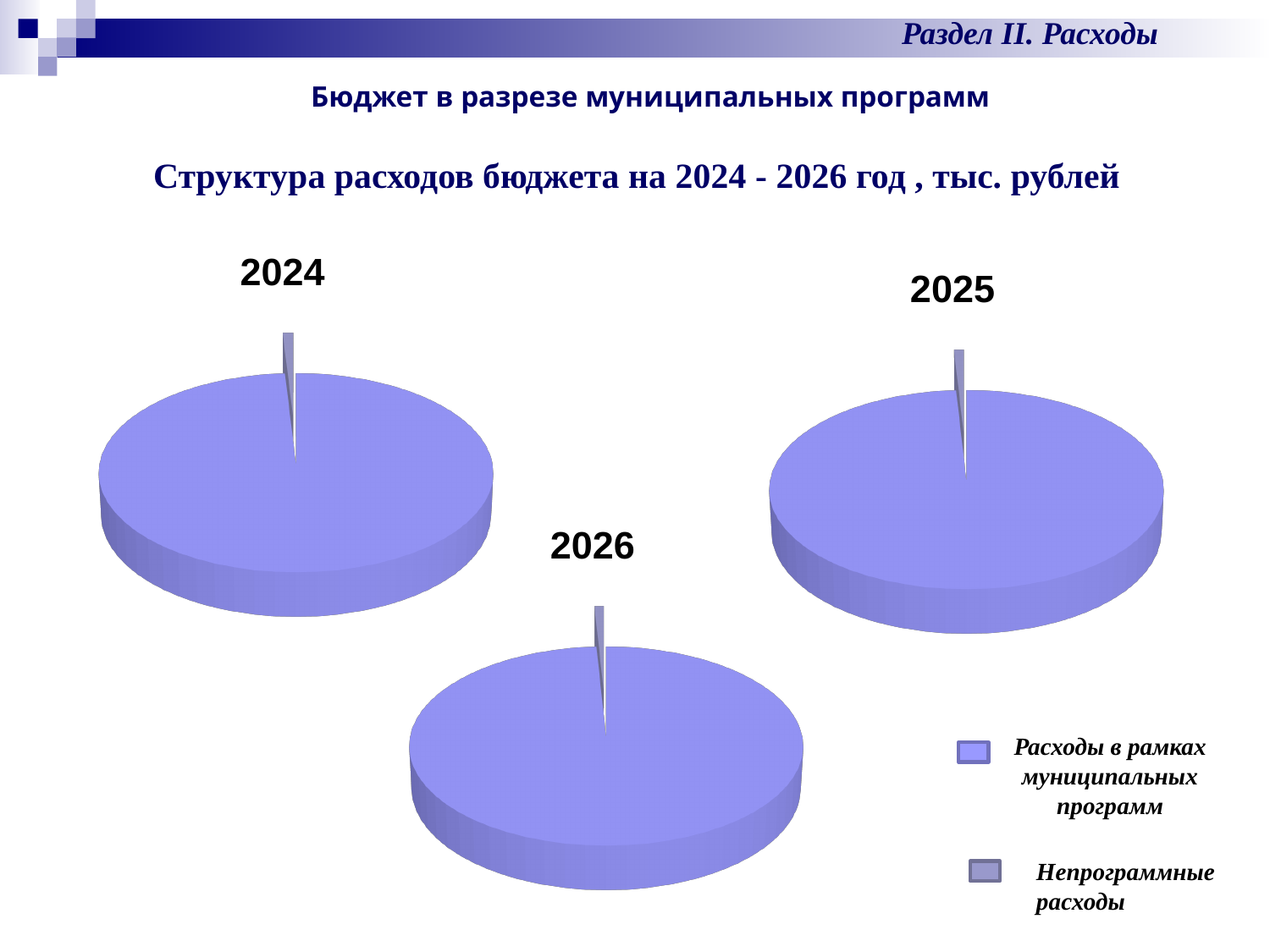
In the 2024 pie chart, which slice is larger: Расходы в рамках муниципальных программ or Непрограммные расходы? Расходы в рамках муниципальных программ What is the title above the three pie charts? Структура расходов бюджета на 2024 - 2026 год , тыс. рублей In the 2026 pie chart, which category has the largest slice? Расходы в рамках муниципальных программ How many pie charts are shown on the slide? 3 What years are the three pie charts labelled with? 2024, 2025, 2026 What kind of chart is used for the 2024 chart? pie chart In the 2026 pie chart, which slice is smaller: Расходы в рамках муниципальных программ or Непрограммные расходы? Непрограммные расходы In the 2025 pie chart, which category has the smallest slice? Непрограммные расходы How many entries does the legend list? 2 How many slices does the 2025 pie chart have? 2